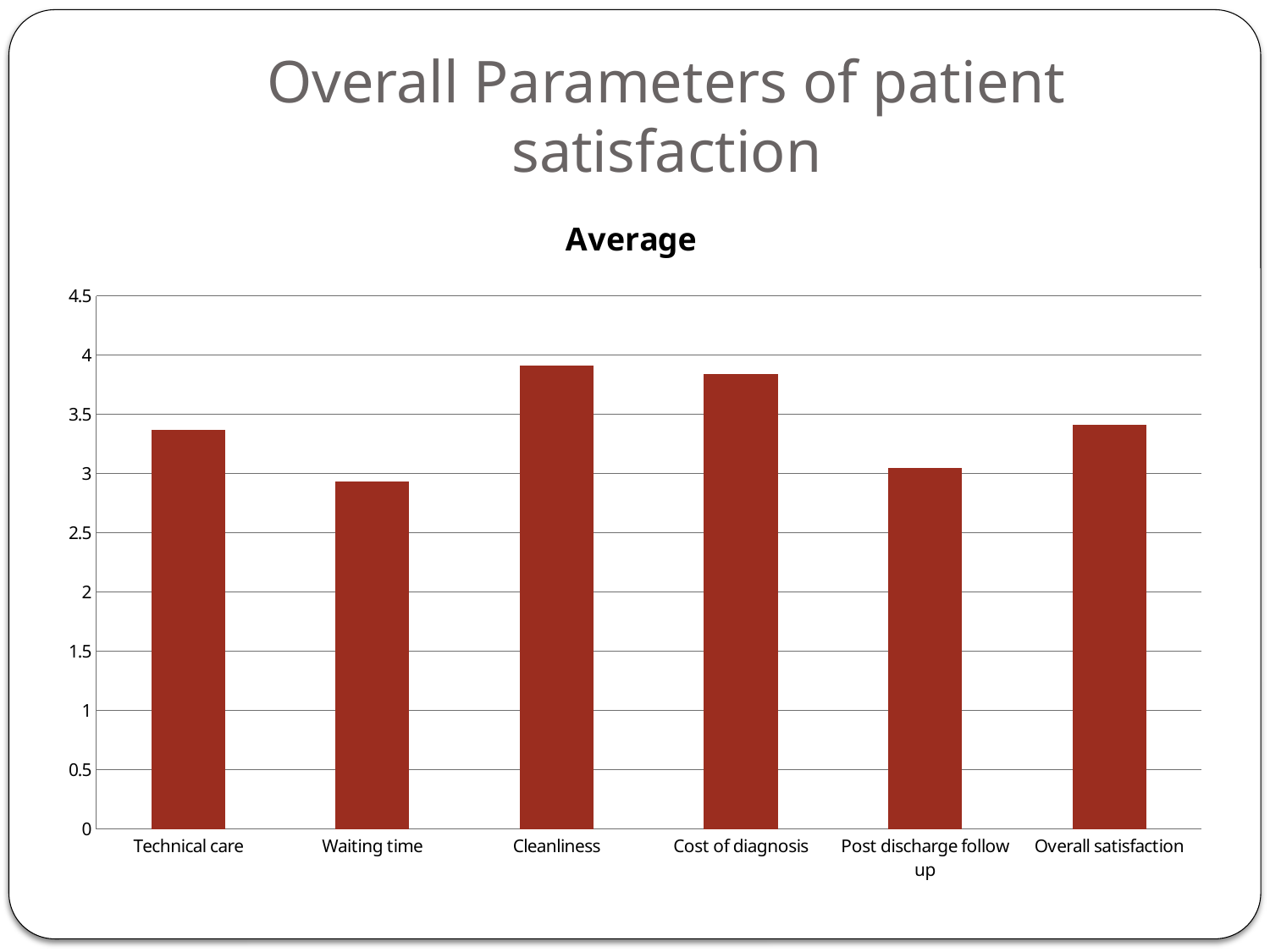
What is the title of the chart? Average What is the highest value shown on the vertical axis? 4.5 Is the value for Technical care greater or less than 3? greater Is the value for Cost of diagnosis greater or less than 3.5? greater What kind of chart is shown on the slide? bar chart Is the value for Cleanliness greater or less than 4? less How many categories are plotted on the chart? 6 Which category has the lowest value on the chart? Waiting time Which is larger, the value for Cleanliness or the value for Waiting time? Cleanliness Which is larger, the value for Technical care or the value for Post discharge follow up? Technical care